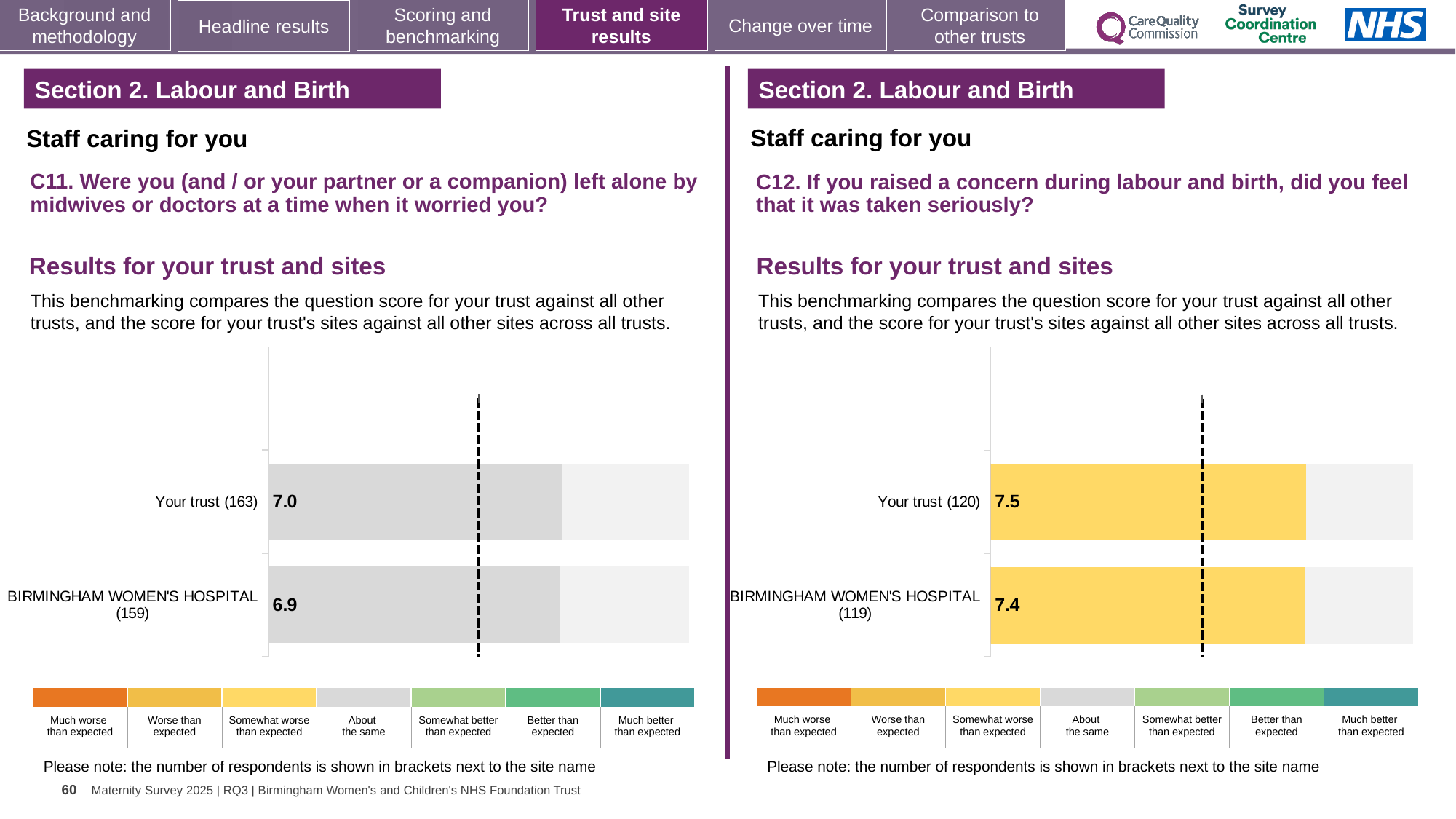
In the C11 chart on the left, what is the score for Your trust? 7.0 In the C12 chart on the right, which benchmark category does the yellow colour of the bars correspond to according to the legend? Somewhat worse than expected In the C12 chart on the right, how many respondents are shown in brackets for Birmingham Women's Hospital? 119 In the C12 chart on the right, how many bars are plotted? 2 In the C11 chart on the left, which benchmark category does the grey colour of the bars correspond to according to the legend? About the same What type of chart is used in the C11 chart on the left? Bar chart In the C11 chart on the left, what is the score for Birmingham Women's Hospital? 6.9 In the C12 chart on the right, what is the score for Birmingham Women's Hospital? 7.4 In the C12 chart on the right, what is the score for Your trust? 7.5 In the C11 chart on the left, how many respondents are shown in brackets for Your trust? 163 In the C12 chart on the right, what is the difference between the Your trust score and the Birmingham Women's Hospital score? 0.1 In the C11 chart on the left, what is the difference between the Your trust score and the Birmingham Women's Hospital score? 0.1